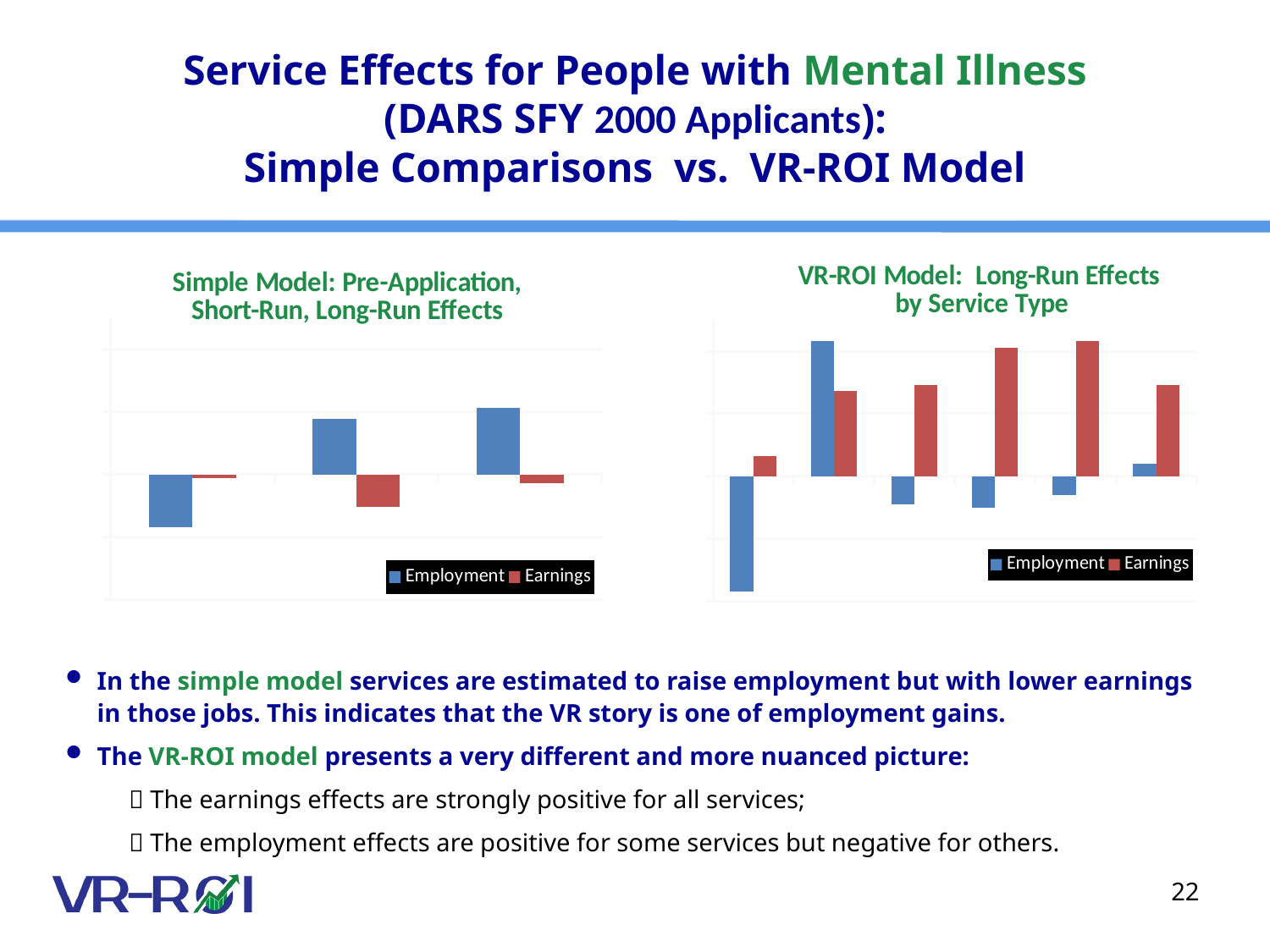
How many groups of bars are plotted in the 'VR-ROI Model' chart on the right? 6 In the 'VR-ROI Model' chart, are the Earnings bars positive or negative for all service types? positive In the 'Simple Model' chart, is the Employment bar in the leftmost group positive or negative? negative In the 'VR-ROI Model' chart, which series has the lowest (most negative) bar? Employment In the 'VR-ROI Model' chart, which series is shown in red? Earnings How many series does the legend of the 'Simple Model' chart list? 2 What kind of chart is the 'VR-ROI Model: Long-Run Effects by Service Type' chart? bar chart In the 'Simple Model' chart, which series is shown in blue? Employment What kind of chart is the 'Simple Model: Pre-Application, Short-Run, Long-Run Effects' chart? bar chart In the 'Simple Model' chart, which series has the highest bar? Employment How many groups of bars are plotted in the 'Simple Model' chart on the left? 3 How many series does the legend of the 'VR-ROI Model' chart list? 2